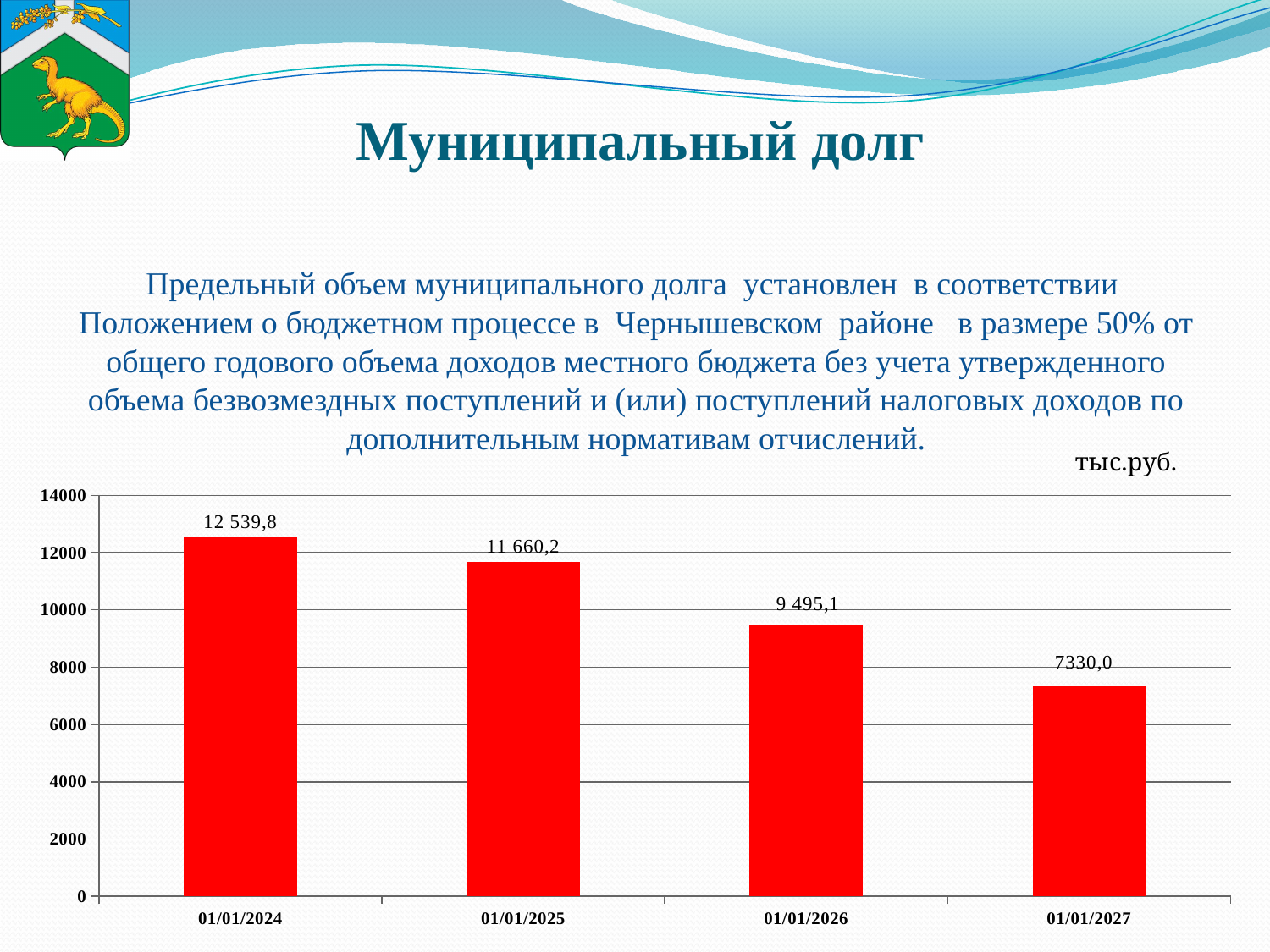
Which is larger, the value for 01/01/2025 or the value for 01/01/2026? 01/01/2025 What is the value for 01/01/2024? 12 539,8 Which date has the highest value? 01/01/2024 Which date has the lowest value? 01/01/2027 What kind of chart is shown on the slide? bar chart What is the value for 01/01/2027? 7330,0 What is the value for 01/01/2026? 9 495,1 How many bars are shown in the chart? 4 What is the value for 01/01/2025? 11 660,2 Do the values rise or fall from 01/01/2024 to 01/01/2027? fall What is the difference between the values for 01/01/2024 and 01/01/2027? 5 209,8 What is the difference between the values for 01/01/2024 and 01/01/2025? 879,6